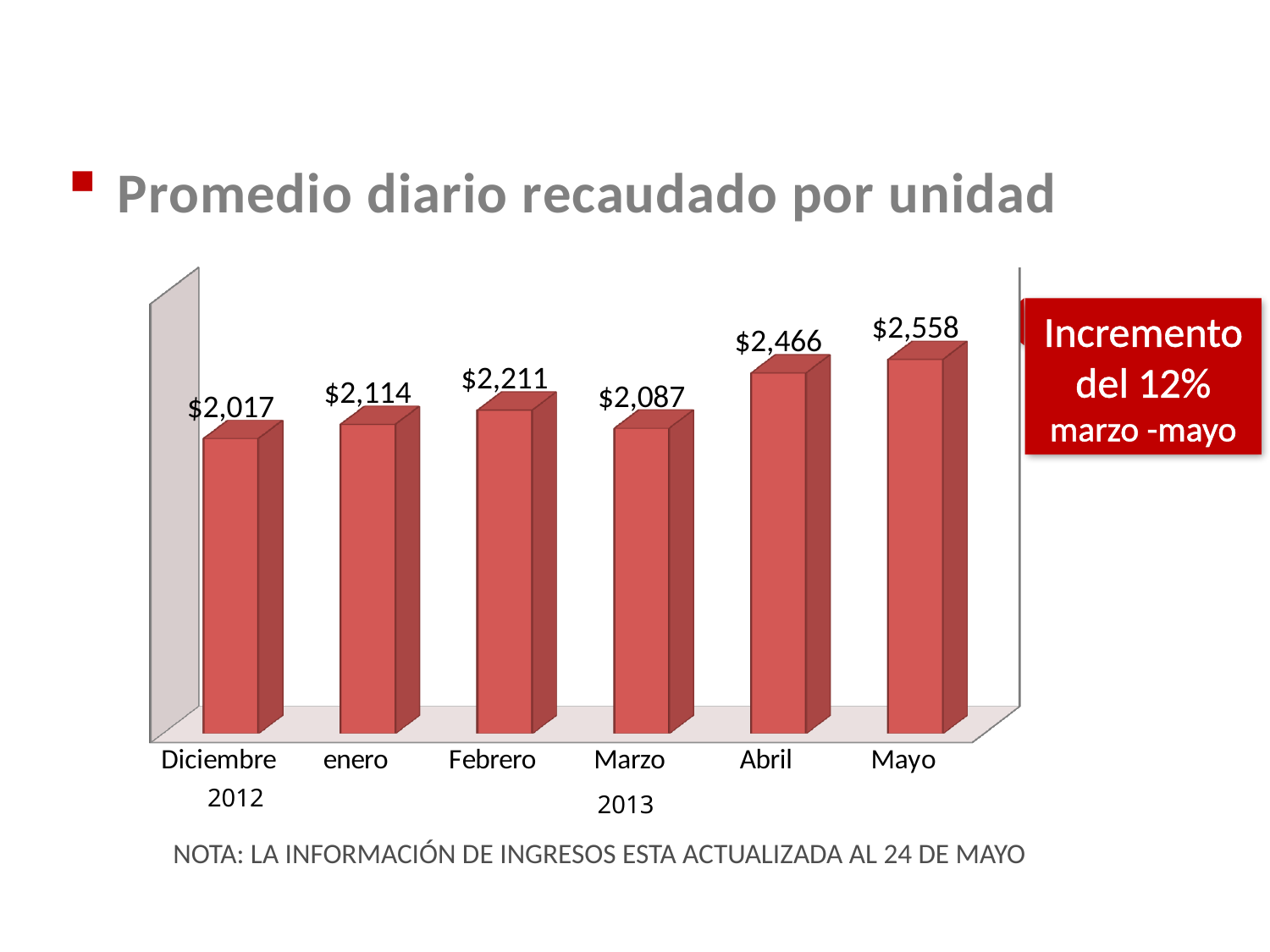
What kind of chart is shown on the slide? Bar chart What is the title of the chart? Promedio diario recaudado por unidad What is the difference between the values for Mayo and Marzo? $471 Which month has the highest value? Mayo What is the value for Mayo? $2,558 Which is larger, the value for Febrero or the value for Marzo? Febrero Do the values rise or fall from Marzo to Mayo? Rise What is the value for Marzo? $2,087 What is the difference between the values for Abril and Diciembre? $449 What is the value for Diciembre? $2,017 How many months are shown in the chart? 6 Which month has the lowest value? Diciembre